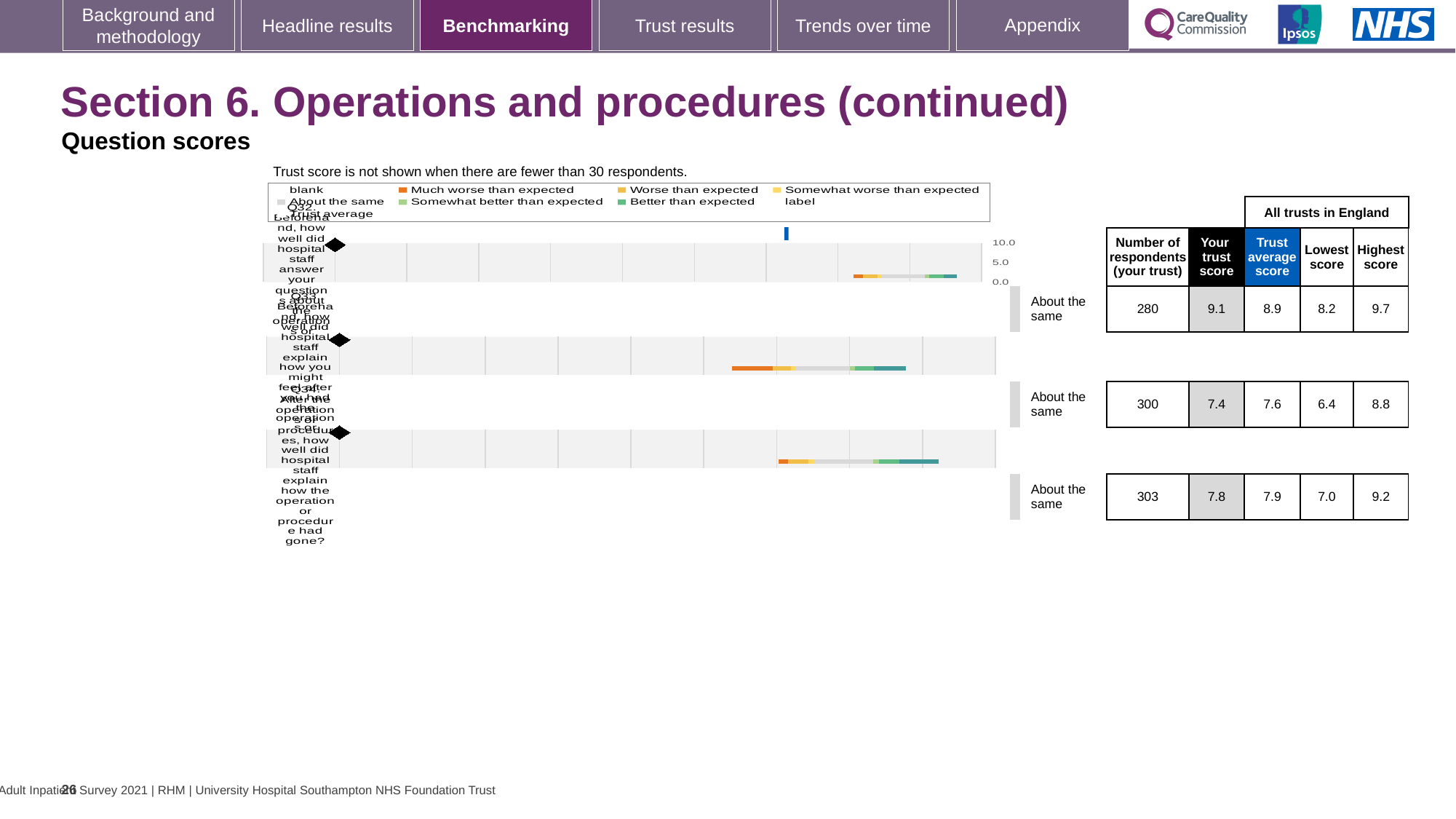
Which question row has the fewest respondents? The first row (280) For the third question row, what is the difference between the 'Highest score' and the 'Lowest score'? 2.2 In the table, what is the 'Lowest score' for the second question row? 6.4 How many question rows are shown in the chart and table? 3 In the table, what is 'Your trust score' for the second question row? 7.4 Which question row has the highest 'Your trust score'? The first row (9.1) In the table, what is the 'Highest score' for the first question row? 9.7 For the first question row, what is the difference between 'Your trust score' and the 'Trust average score'? 0.2 In the table, what is the number of respondents for the first question row? 280 What benchmark category is shown next to each of the three questions? About the same For the second question row, which is larger: 'Your trust score' or the 'Trust average score'? Trust average score (7.6) In the table, what is the 'Trust average score' for the third question row? 7.9